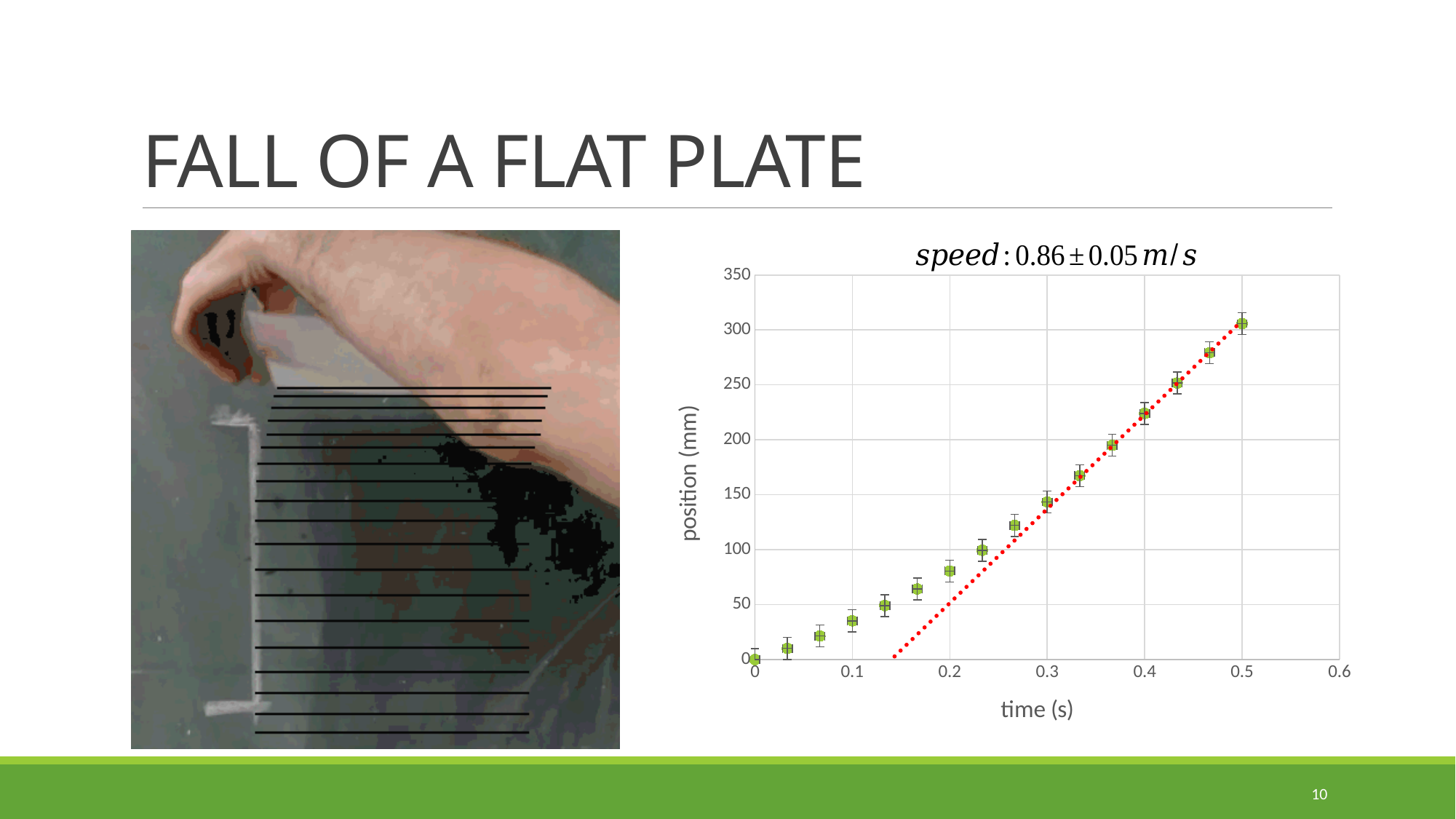
Is the position value at time 0.3 s greater or less than 150? less What kind of chart is shown on the slide? scatter chart At which time value is the plotted position highest? 0.5 Is the position value at time 0.4 s greater or less than 200? greater Do the plotted position values rise or fall as time increases? rise How many data points are plotted on the chart? 16 Is the position value at time 0.1 s greater or less than 50? less What is the label of the y axis of the chart? position (mm) What is the label of the x axis of the chart? time (s) At which time value is the plotted position lowest? 0 Which is larger, the position at time 0.2 s or the position at time 0.3 s? 0.3 s